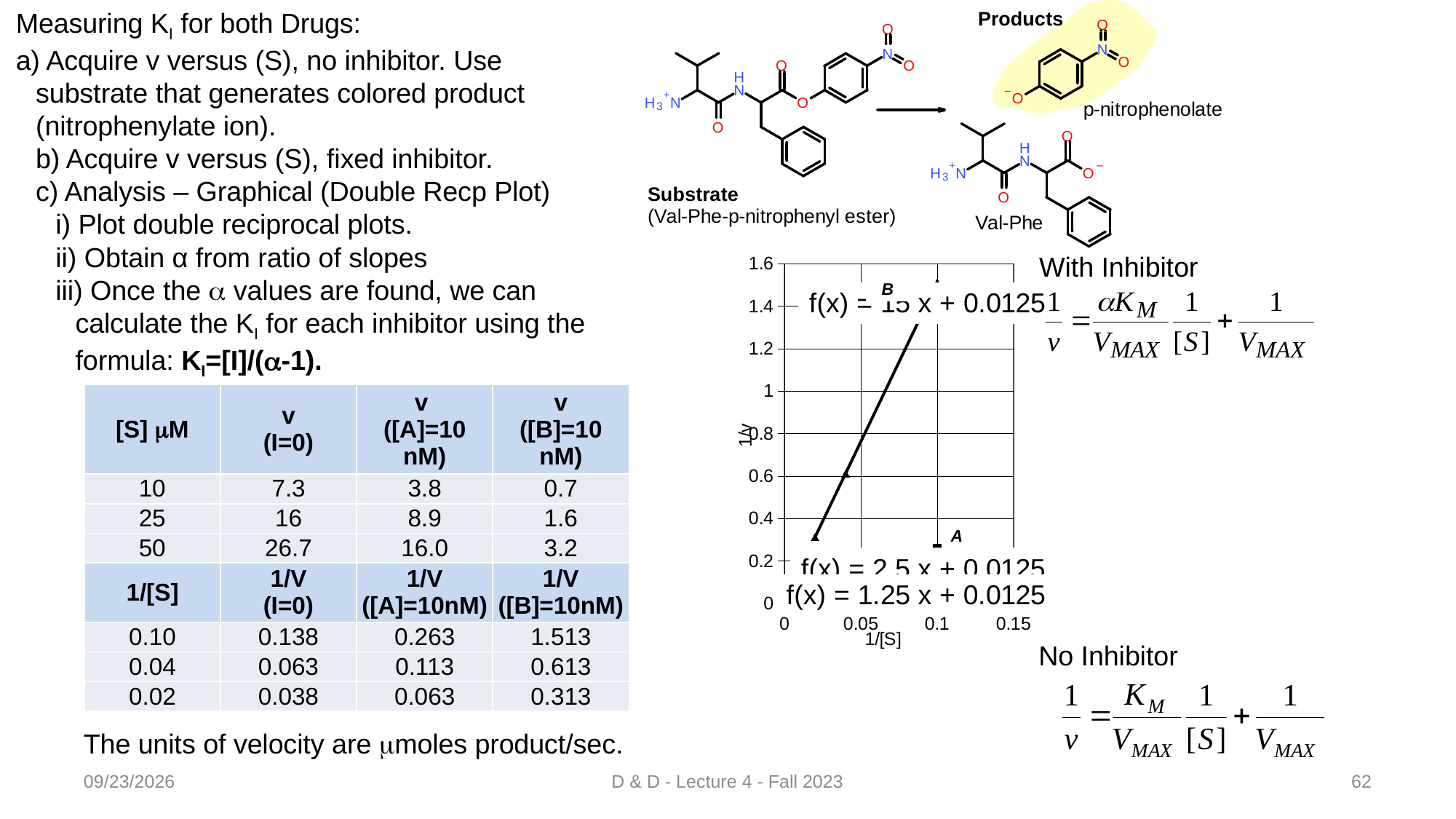
What y-intercept do all three fitted lines on the double reciprocal plot share? 0.0125 What kind of chart is the double reciprocal plot on the slide? line chart Which series on the double reciprocal plot has the steepest slope? B Which fitted line on the double reciprocal plot has the smallest slope? no inhibitor (f(x) = 1.25 x + 0.0125) What is the fitted line equation shown for series B on the double reciprocal plot? f(x) = 15 x + 0.0125 What is the label on the x axis of the double reciprocal plot? 1/[S] What is the fitted line equation shown for series A on the double reciprocal plot? f(x) = 2.5 x + 0.0125 What is the fitted line equation shown for the no-inhibitor data on the double reciprocal plot? f(x) = 1.25 x + 0.0125 What is the label on the y axis of the double reciprocal plot? 1/V What is the difference between the slope of series B and the slope of series A on the double reciprocal plot? 12.5 On the double reciprocal plot, does 1/V rise or fall as 1/[S] increases? rise On the double reciprocal plot, which has the larger slope, series A or series B? B